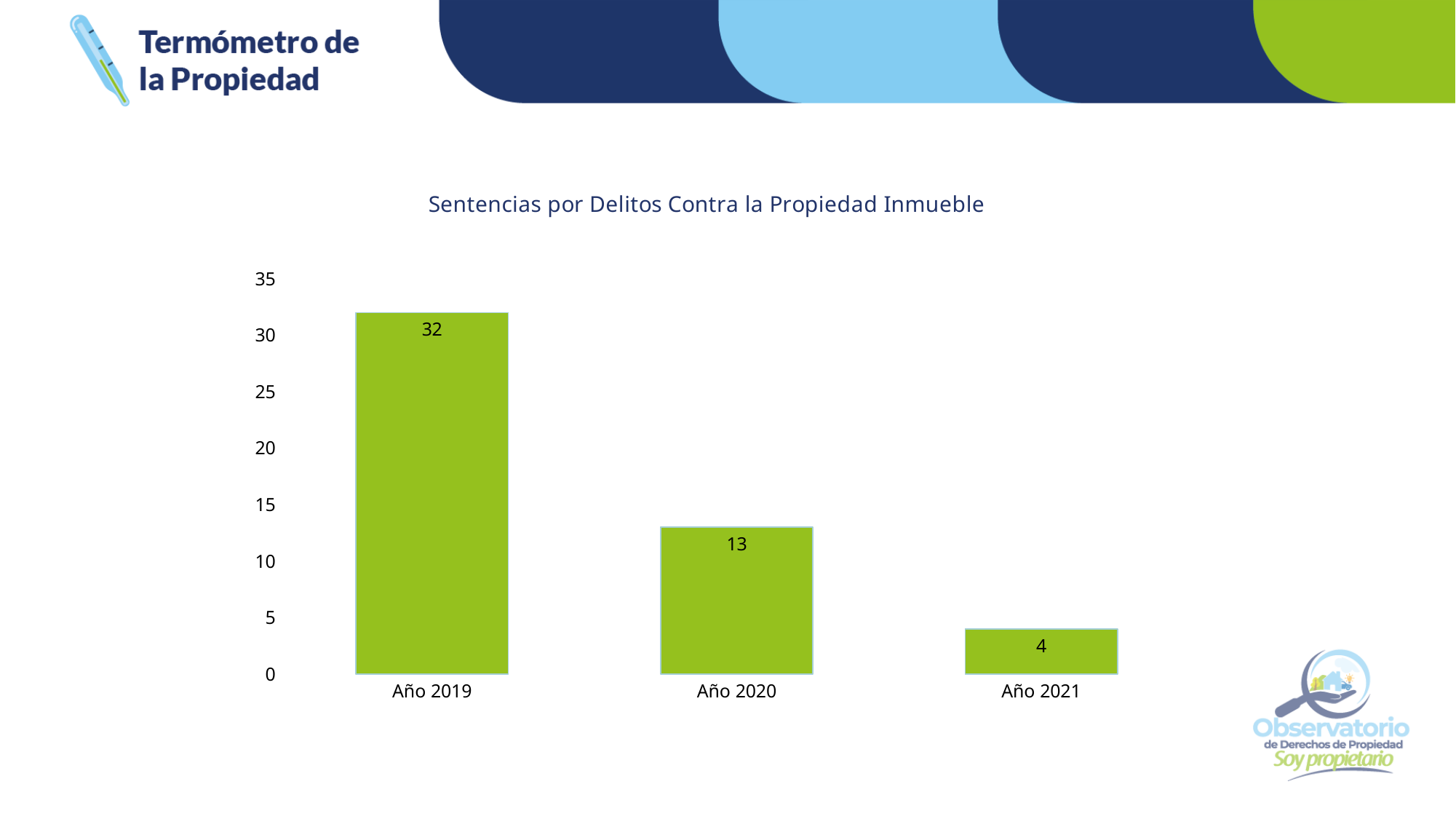
Which year has the highest value? Año 2019 Which year has the lowest value? Año 2021 Is the value for Año 2019 greater or less than 30? greater What is the difference between the values for Año 2020 and Año 2021? 9 Which is larger, the value for Año 2020 or the value for Año 2021? Año 2020 How many years are shown on the chart? 3 What is the value for Año 2020? 13 What kind of chart is shown on the slide? bar chart Do the values rise or fall from Año 2019 to Año 2021? fall What is the value for Año 2019? 32 What is the difference between the values for Año 2019 and Año 2020? 19 What is the value for Año 2021? 4